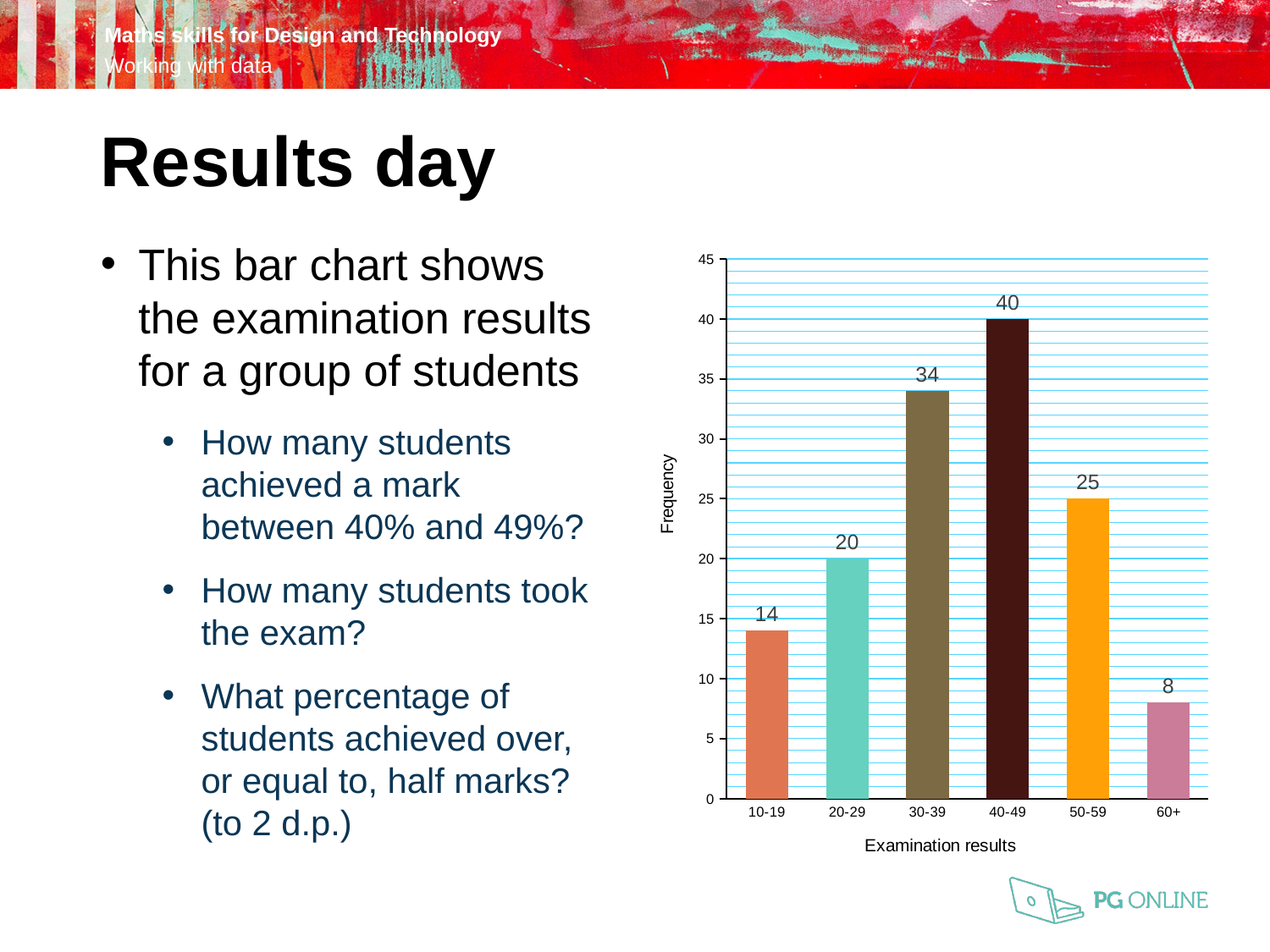
What is the difference in frequency between the 50-59 and 60+ categories? 17 Which has a higher frequency, 20-29 or 50-59? 50-59 What is the frequency for the 40-49 examination results category? 40 How many examination results categories are shown on the x axis? 6 What is the frequency for the 10-19 category? 14 What kind of chart is shown on the slide? bar chart What is the difference in frequency between the 40-49 and 30-39 categories? 6 Which examination results category has the highest frequency? 40-49 What is the label of the y axis of the chart? Frequency What is the label of the x axis of the chart? Examination results What is the frequency for the 60+ category? 8 Which examination results category has the lowest frequency? 60+